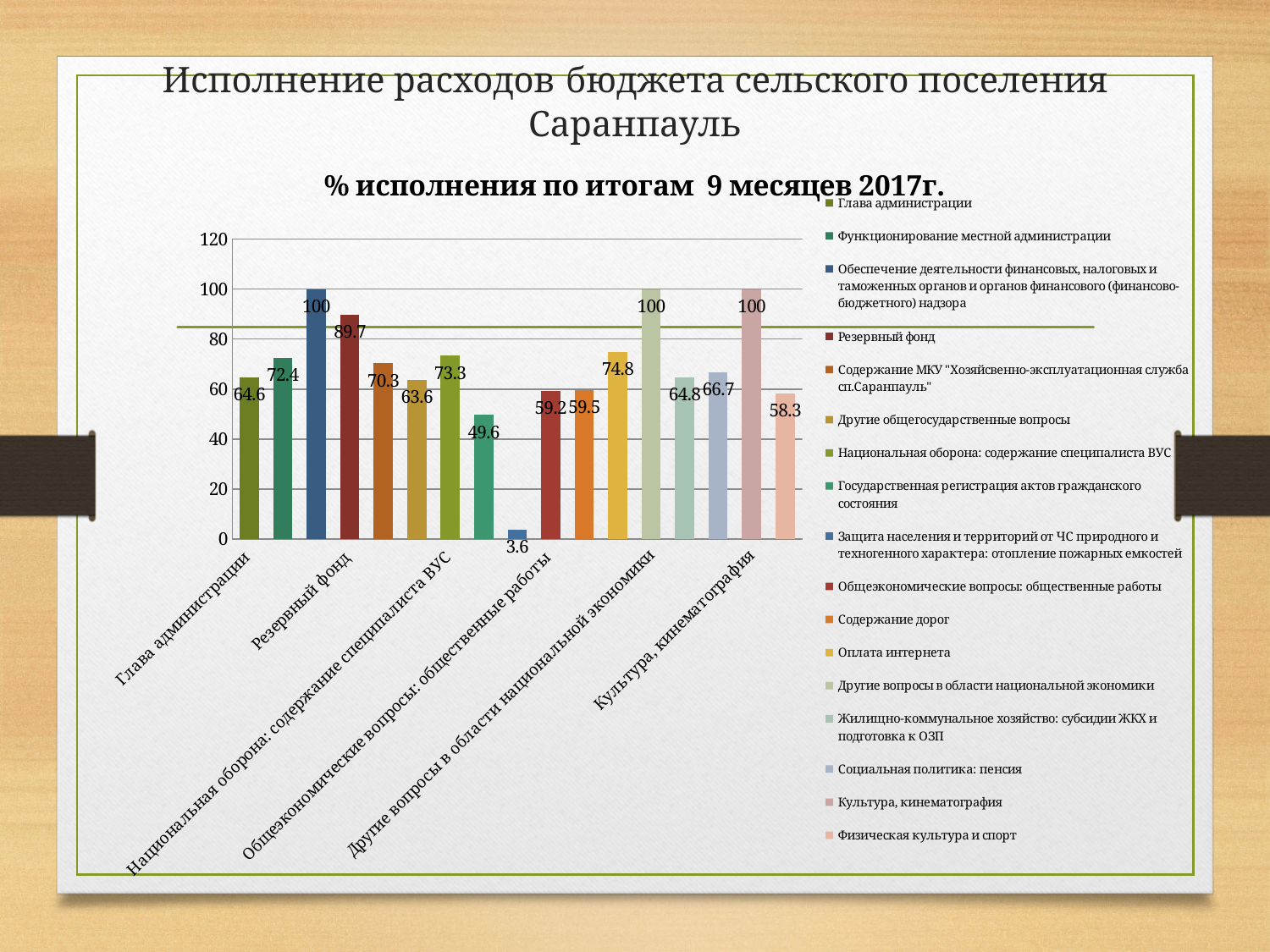
What is the value for Оплата интернета? 74.8 What is the title of the chart? % исполнения по итогам 9 месяцев 2017г. What kind of chart is shown on the slide? bar chart What is the value for Физическая культура и спорт? 58.3 How many series does the legend list? 17 What is the value for Защита населения и территорий от ЧС природного и техногенного характера: отопление пожарных емкостей? 3.6 Which series has the lowest value? Защита населения и территорий от ЧС природного и техногенного характера: отопление пожарных емкостей What is the value for Социальная политика: пенсия? 66.7 What is the value for Резервный фонд? 89.7 Which is larger, the value for Оплата интернета or the value for Содержание дорог? Оплата интернета What is the difference between the values for Резервный фонд and Глава администрации? 25.1 Is the value for Национальная оборона: содержание специалиста ВУС greater or less than 60? greater